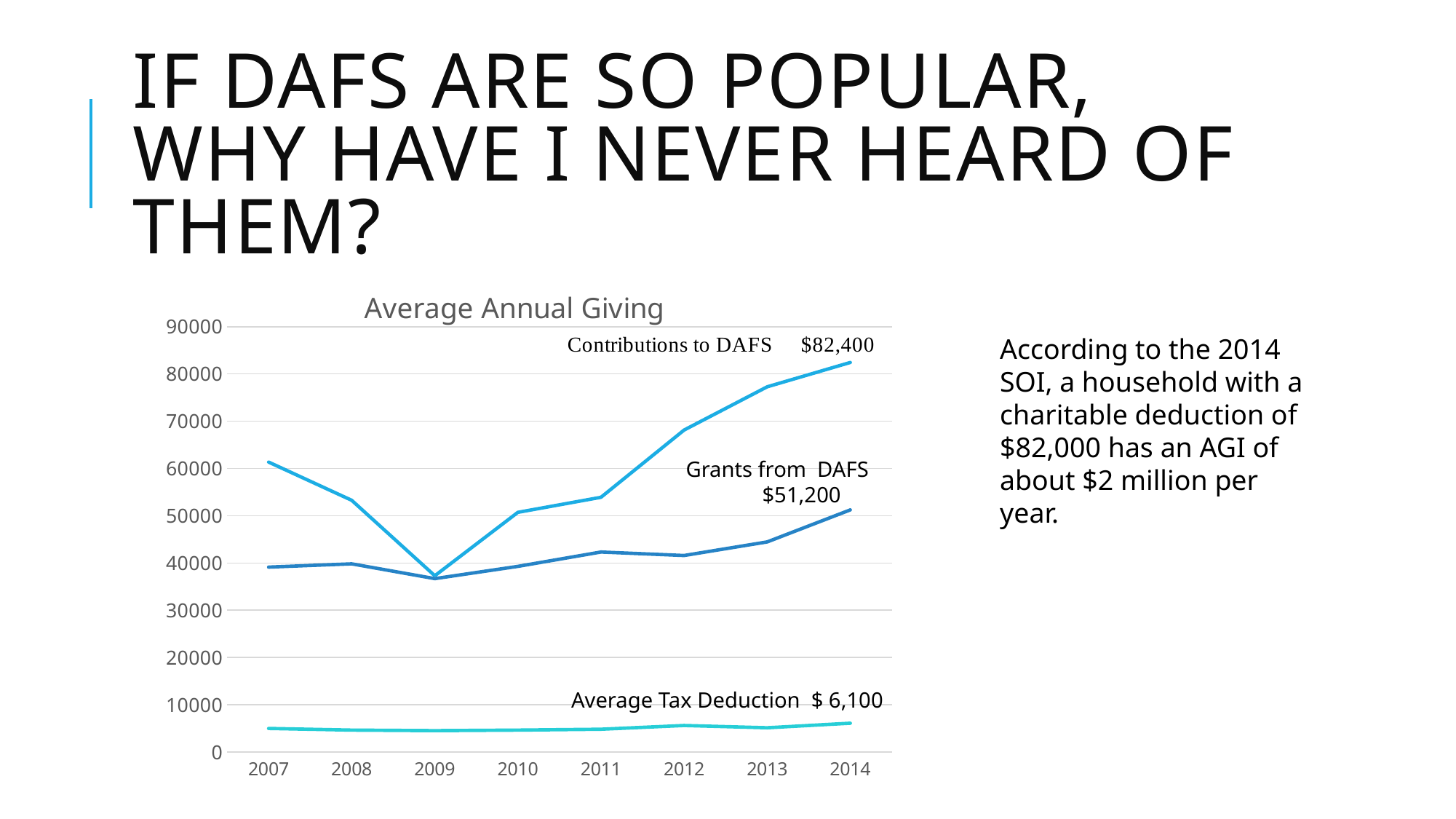
How many years are shown on the x axis? 8 How many lines are plotted on the chart? 3 What is the difference between Contributions to DAFS and Grants from DAFS in 2014? $31,200 What kind of chart is shown on the slide? line chart What is the value of Grants from DAFS in 2014? $51,200 What is the value of Contributions to DAFS in 2014? $82,400 Which line has the highest value in 2014? Contributions to DAFS Which line has the lowest values across all years? Average Tax Deduction In which year does the Contributions to DAFS line reach its lowest point? 2009 Is the value for Contributions to DAFS in 2013 greater or less than 80000? less What is the title of the chart? Average Annual Giving What is the value of Average Tax Deduction in 2014? $ 6,100